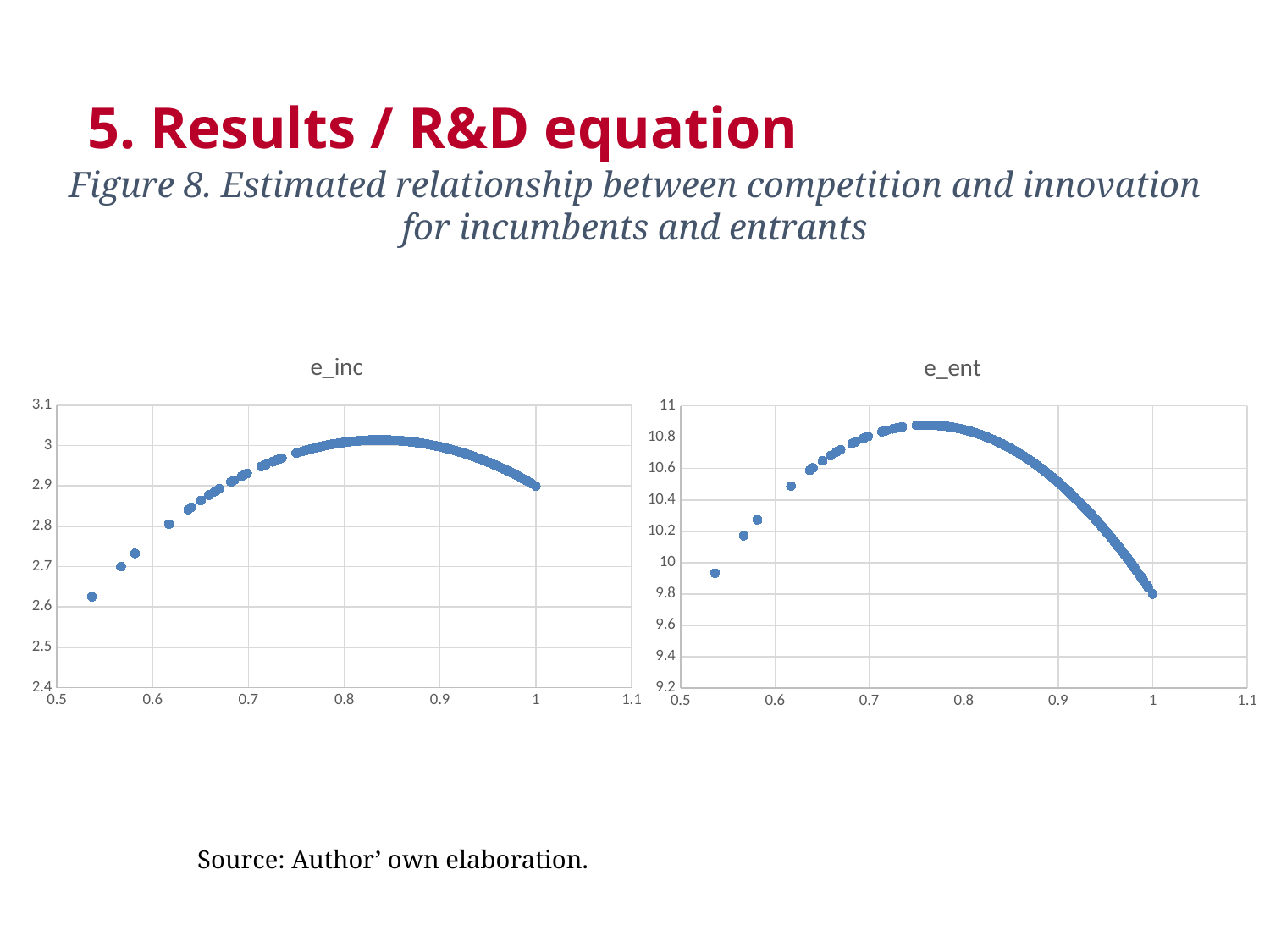
In the e_ent chart, is the leftmost plotted value greater or less than 9.8? greater In the e_inc chart, is the highest plotted value greater or less than 2.9? greater What is the title of the chart on the right? e_ent In the e_inc chart, is the lowest plotted value (at the far left) greater or less than 2.7? less What kind of chart is the e_inc chart? scatter chart How many charts are shown on the slide? 2 What kind of chart is the e_ent chart? scatter chart In the e_ent chart, do the values rise or fall as x increases from 0.8 to 1? fall In the e_inc chart, do the values rise or fall as x increases from 0.5 to about 0.8? rise What is the highest value shown on the y axis of the e_ent chart? 11